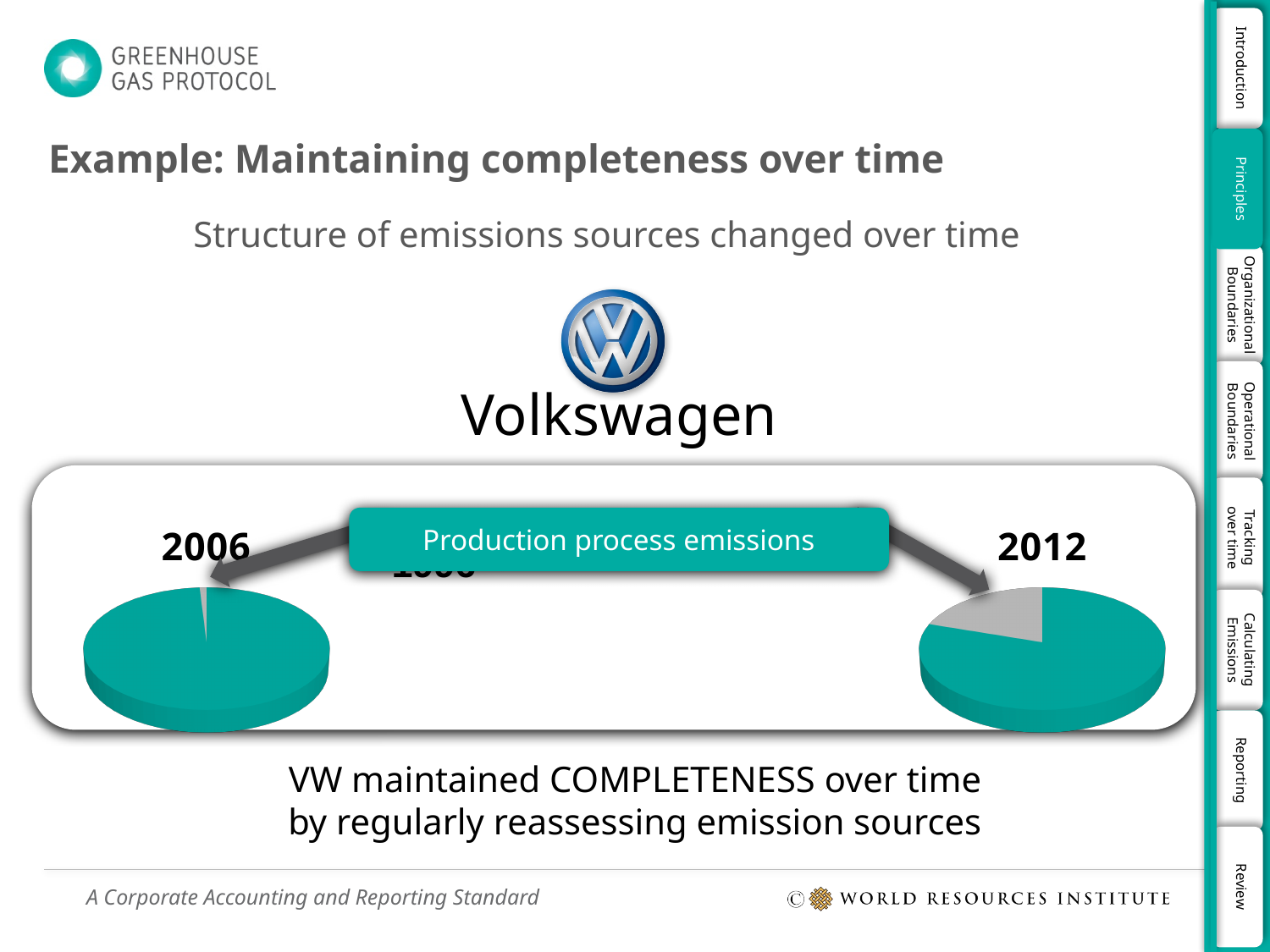
What kind of chart is used to show the 2012 emissions structure? Pie chart Which years are the two pie charts labelled with? 2006 and 2012 What label is shown in the box between the two pie charts? Production process emissions How many pie charts are shown on the slide? 2 How many slices does the 2006 pie chart have? 2 Which pie chart has the larger grey slice, 2006 or 2012? 2012 In the 2006 pie chart, which slice is larger, the teal slice or the grey slice? The teal slice What kind of chart is used to show the 2006 emissions structure? Pie chart How many slices does the 2012 pie chart have? 2 Does the grey slice of the pie grow or shrink from 2006 to 2012? Grow In the 2012 pie chart, which slice is larger, the teal slice or the grey slice? The teal slice